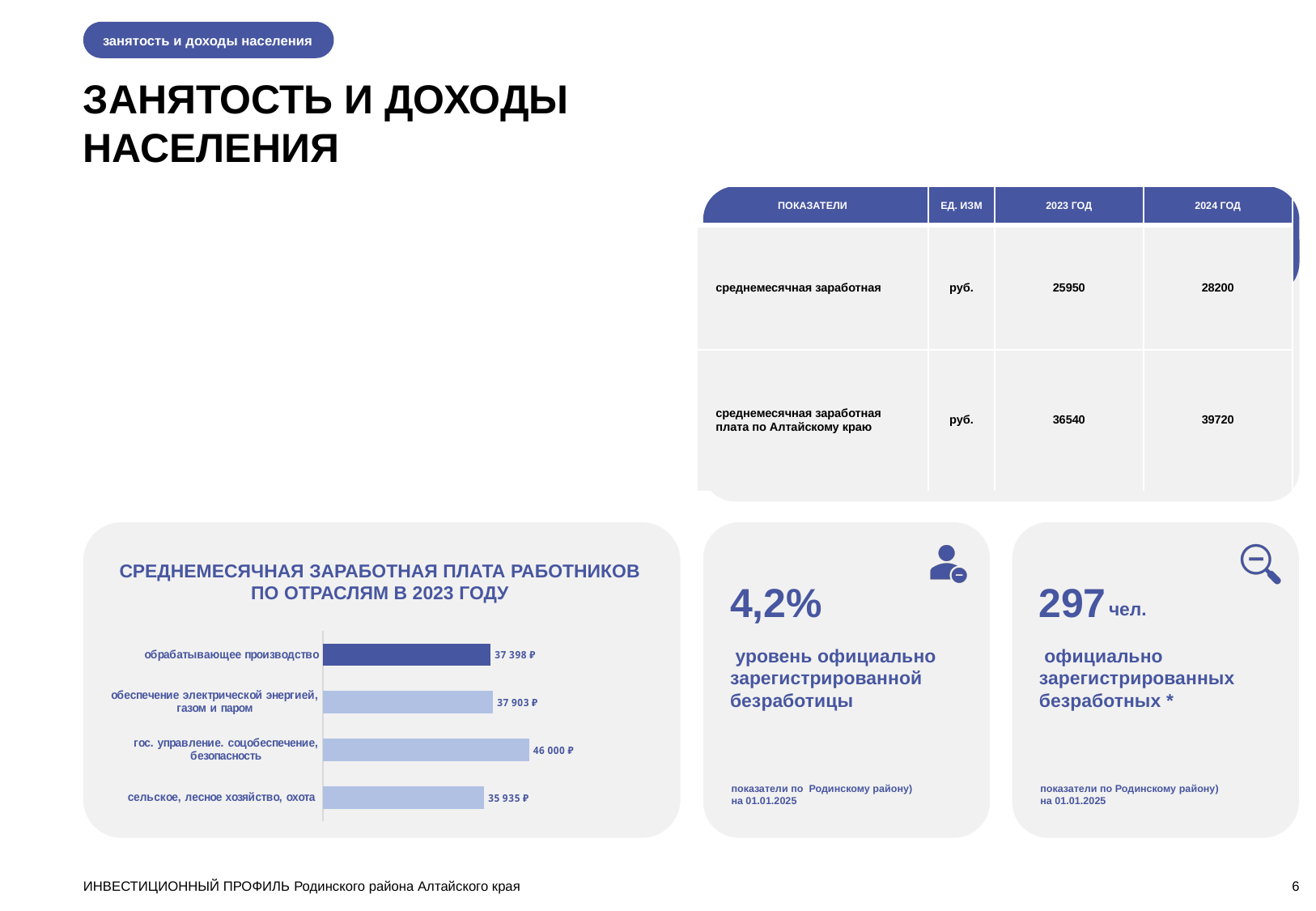
What is the average monthly salary for гос. управление, соцобеспечение, безопасность? 46 000 ₽ What is the average monthly salary for обрабатывающее производство? 37 398 ₽ Which is larger: the salary for гос. управление, соцобеспечение, безопасность or for обрабатывающее производство? гос. управление, соцобеспечение, безопасность What is the average monthly salary for обеспечение электрической энергией, газом и паром? 37 903 ₽ What type of chart is shown on the slide? bar chart What is the difference between the salary for обеспечение электрической энергией, газом и паром and обрабатывающее производство? 505 ₽ How many industries are shown in the bar chart? 4 Which industry has the lowest average monthly salary in the chart? сельское, лесное хозяйство, охота What is the average monthly salary for сельское, лесное хозяйство, охота? 35 935 ₽ What is the difference between the salary for гос. управление, соцобеспечение, безопасность and сельское, лесное хозяйство, охота? 10 065 ₽ Which industry has the highest average monthly salary in the chart? гос. управление, соцобеспечение, безопасность What is the title of the bar chart? СРЕДНЕМЕСЯЧНАЯ ЗАРАБОТНАЯ ПЛАТА РАБОТНИКОВ ПО ОТРАСЛЯМ В 2023 ГОДУ